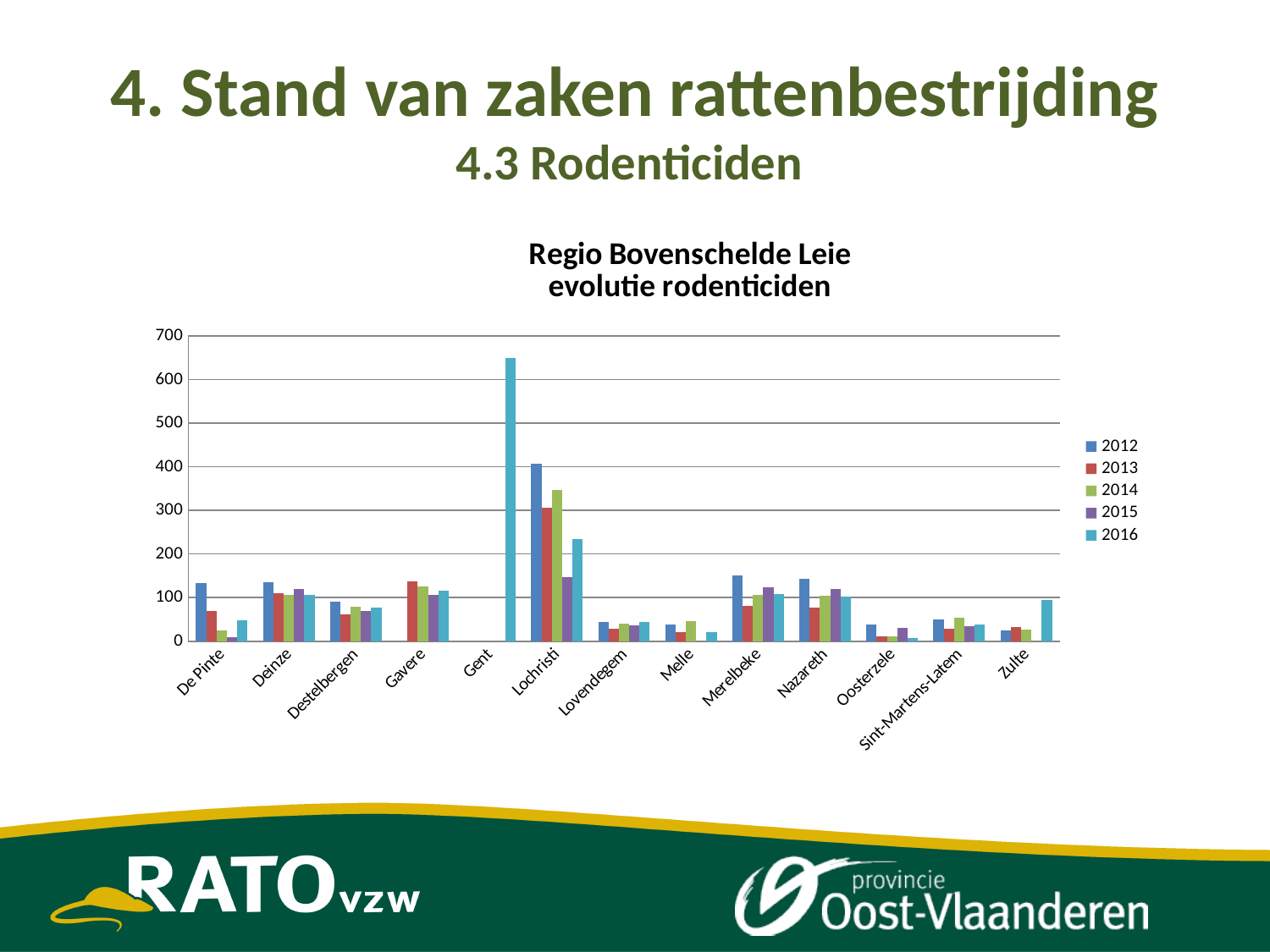
For Lochristi, which is larger: the 2012 value or the 2013 value? 2012 Which years are listed in the legend? 2012, 2013, 2014, 2015, 2016 Which municipality has the tallest bar in the chart? Gent Is the 2012 value for Merelbeke greater or less than 100? greater What kind of chart is shown on the slide? bar chart Which municipality has the highest value for 2012? Lochristi Is the 2014 value for Lochristi greater or less than 300? greater Is the 2014 value for De Pinte greater or less than 100? less What is the title of the chart? Regio Bovenschelde Leie evolutie rodenticiden How many municipalities (categories) are shown on the x axis? 13 How many series does the legend list? 5